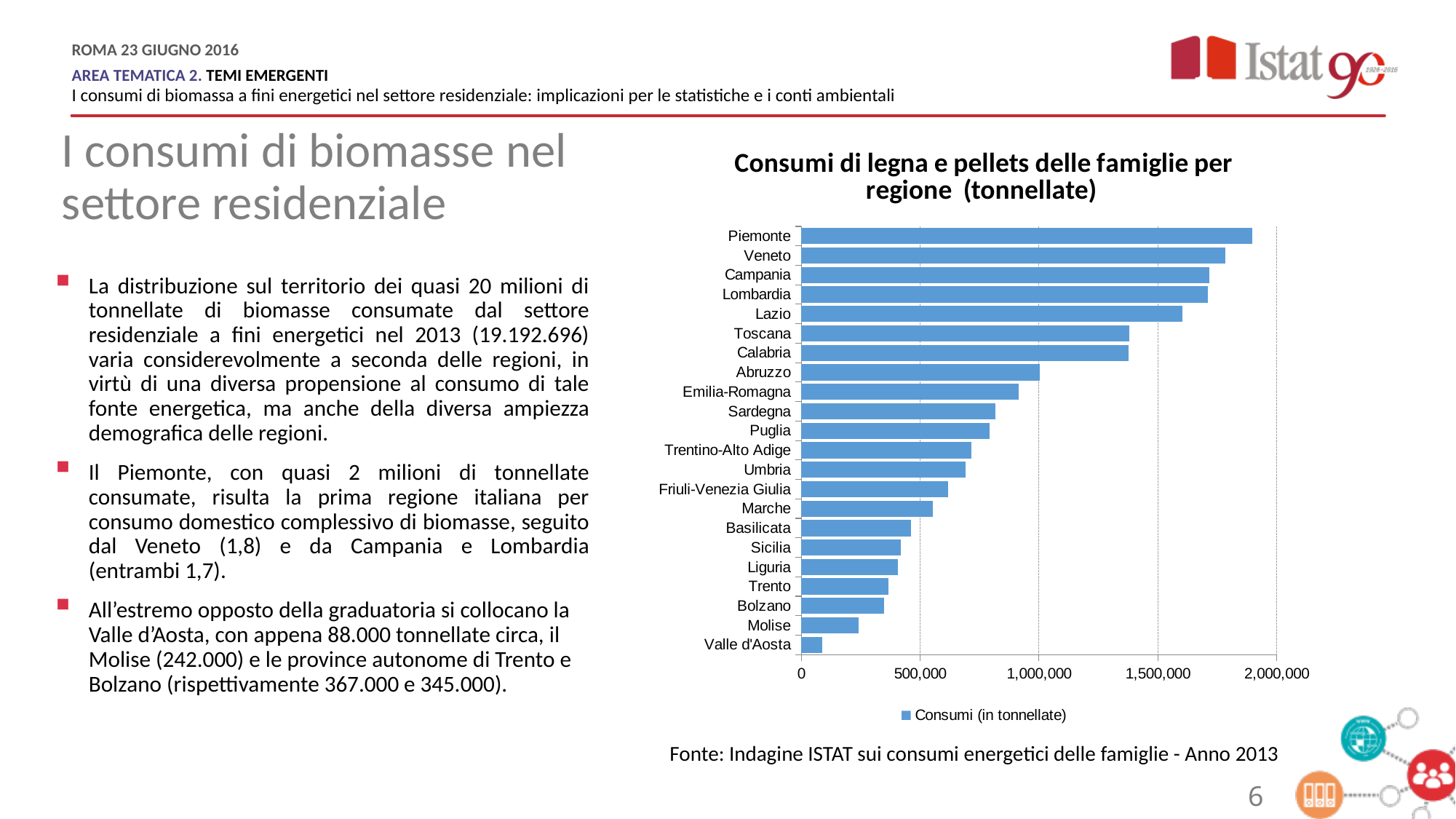
How many regions are listed in the chart? 22 What is the title of the chart? Consumi di legna e pellets delle famiglie per regione (tonnellate) Which has a larger value, Veneto or Campania? Veneto Is the value for Molise greater or less than 500,000? less Is the value for Toscana greater or less than 1,500,000? less Which has a larger value, Molise or Valle d'Aosta? Molise Is the value for Emilia-Romagna greater or less than 1,000,000? less What kind of chart is shown on the slide? Bar chart Which region has the highest consumption of wood and pellets in the chart? Piemonte How many series does the legend list? 1 Which region has the lowest consumption of wood and pellets in the chart? Valle d'Aosta